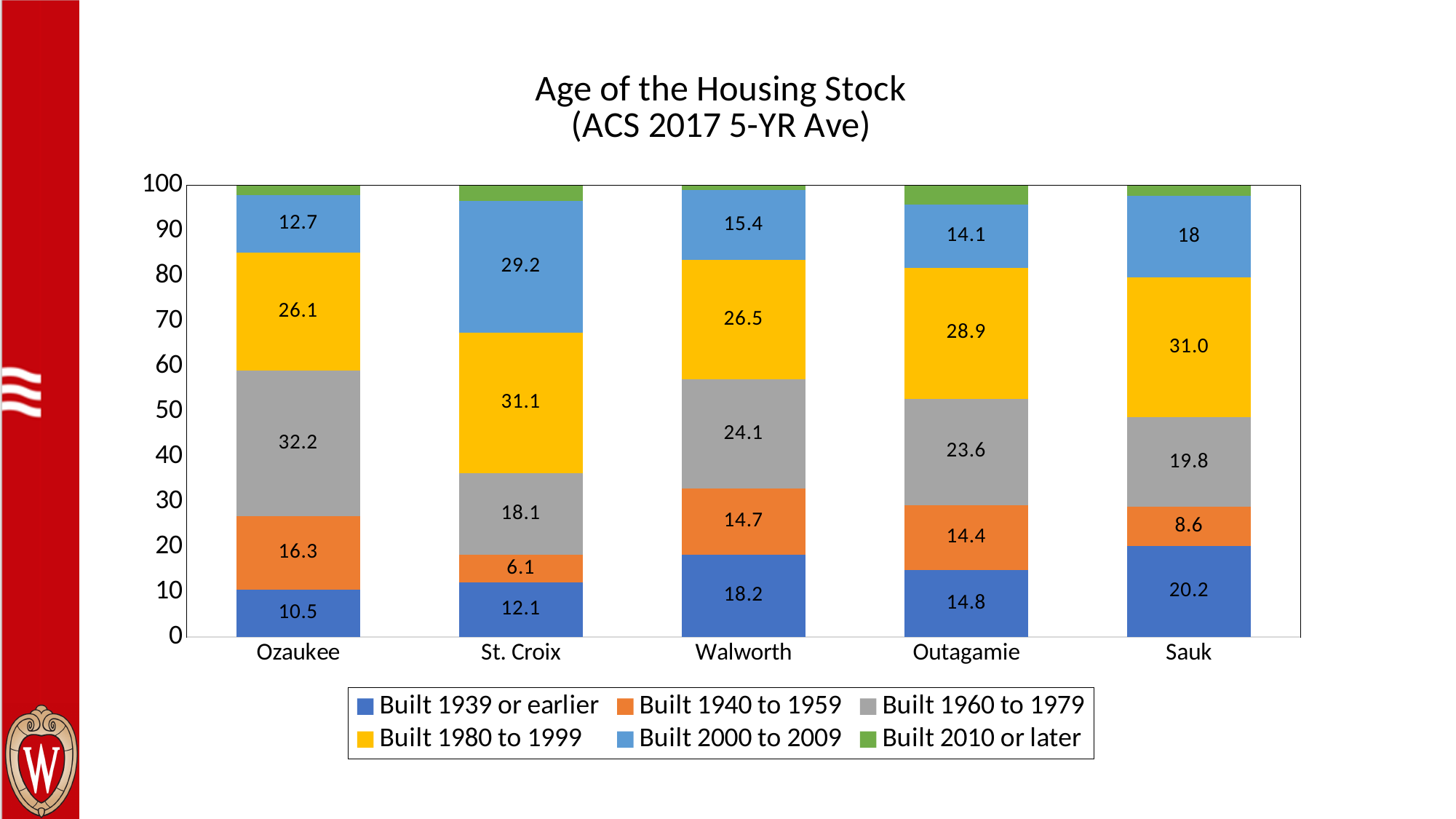
Which county has the highest value for Built 1939 or earlier? Sauk What kind of chart is shown on the slide? Stacked bar chart How many counties are shown on the x axis? 5 How many series does the legend list? 6 What is the value for Built 1939 or earlier in Walworth? 18.2 What is the difference between the Built 1980 to 1999 values for Sauk and Ozaukee? 4.9 What is the value for Built 1960 to 1979 in Ozaukee? 32.2 Which county has the highest value for Built 2000 to 2009? St. Croix What is the title of the chart? Age of the Housing Stock (ACS 2017 5-YR Ave) Which county has the lowest value for Built 1940 to 1959? St. Croix What is the value for Built 2000 to 2009 in St. Croix? 29.2 Which is larger, the Built 1960 to 1979 value for Walworth or for Outagamie? Walworth